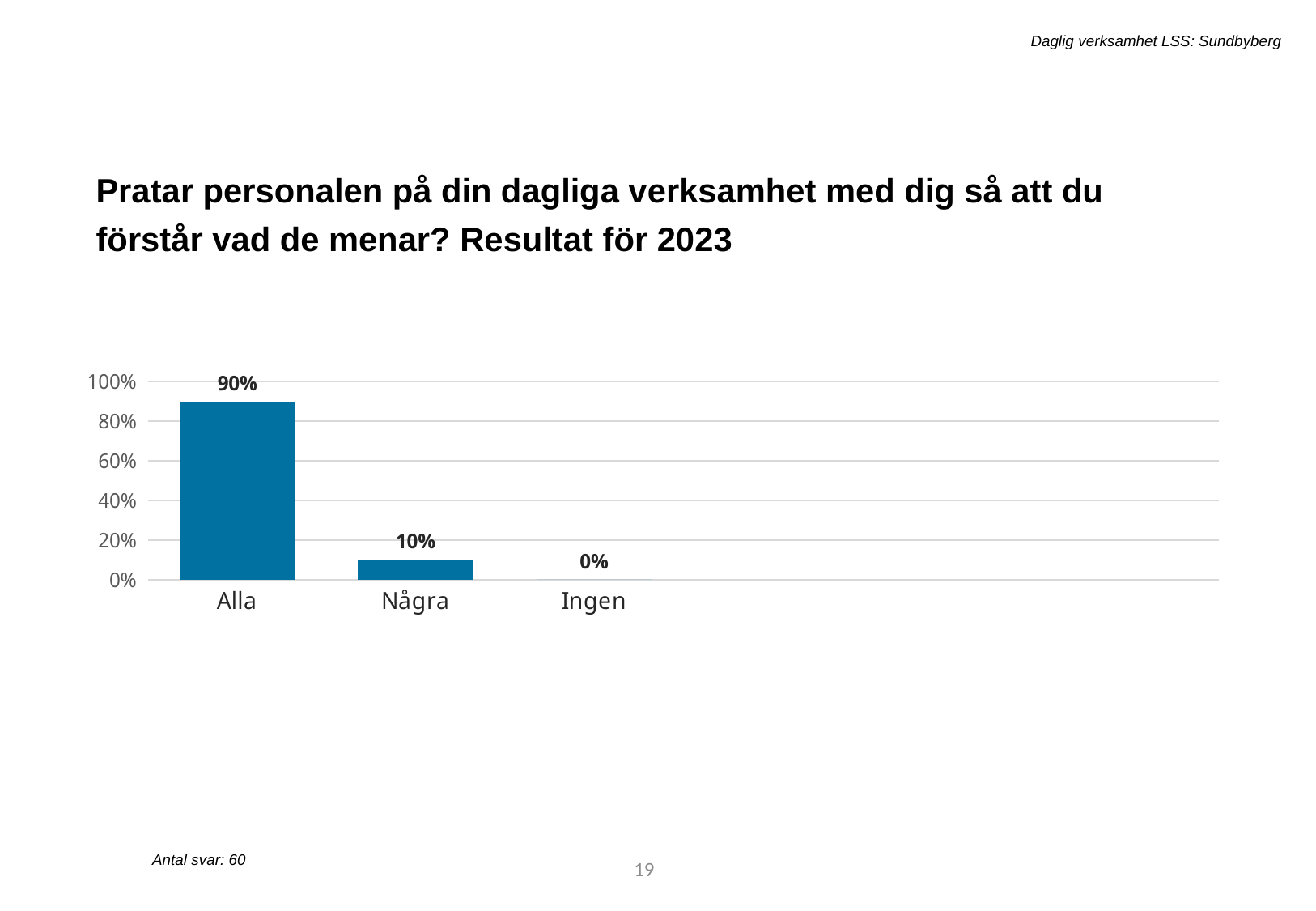
Which is larger, the value for Några or the value for Ingen? Några How many categories are shown on the x axis? 3 What is the difference between the values for Alla and Några? 80% Is the value for Alla greater or less than 80%? greater Which category has the lowest value? Ingen How many responses (Antal svar) does the slide report? 60 What kind of chart is shown on the slide? bar chart What is the value for Några? 10% Do the values rise or fall from left to right along the x axis? fall What is the value for Alla? 90% Which category has the highest value? Alla What is the value for Ingen? 0%